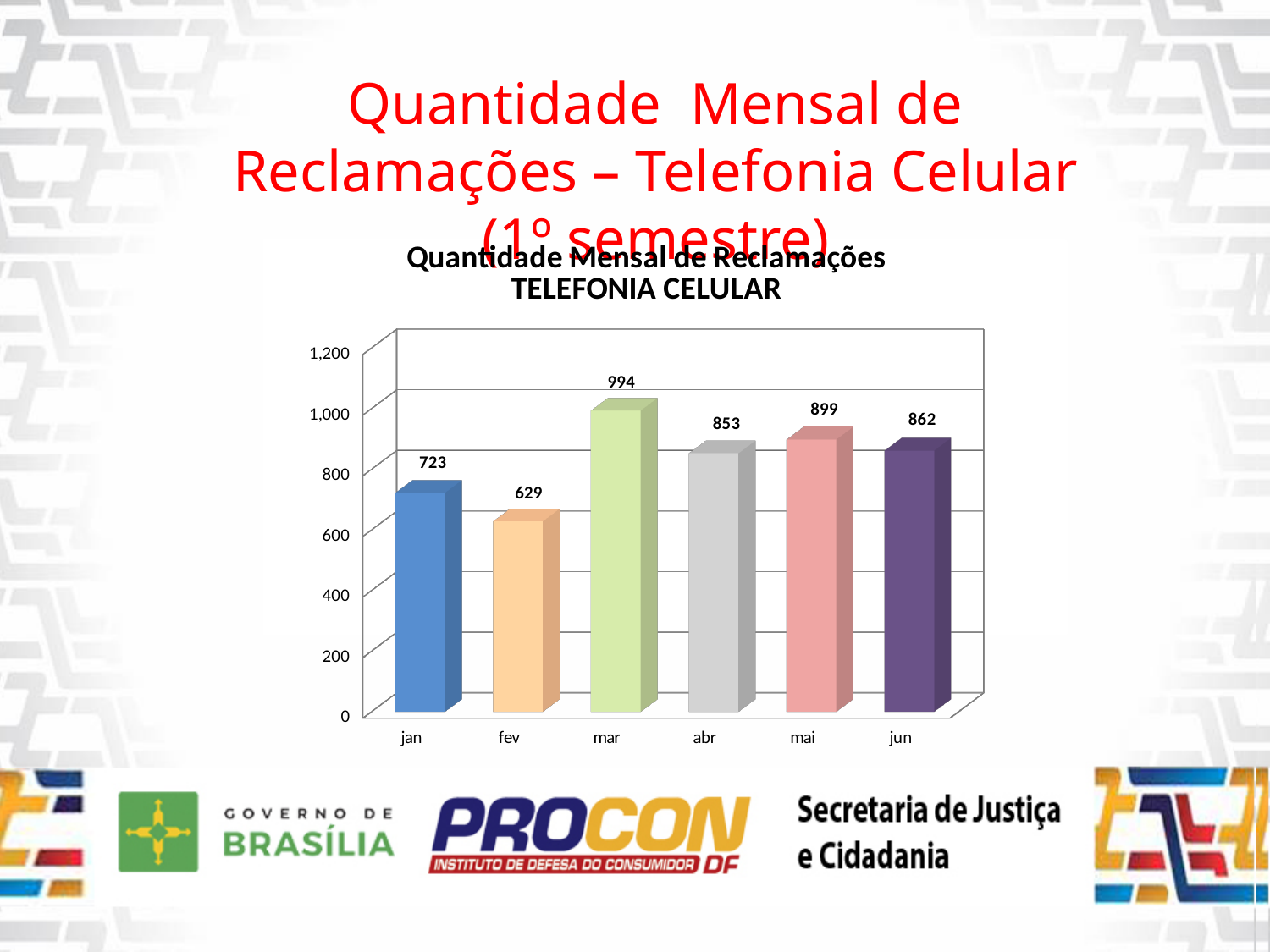
How many months are shown on the x axis? 6 Which is larger, the value for jan or the value for abr? abr What is the value for mar? 994 What is the value for jun? 862 Which month has the lowest number of complaints? fev What kind of chart is shown on the slide? bar chart Is the value for jan greater or less than 800? less What is the title of the chart? Quantidade Mensal de Reclamações TELEFONIA CELULAR What is the value for fev? 629 Which month has the highest number of complaints? mar What is the difference between the values for mai and abr? 46 What is the difference between the values for mar and fev? 365